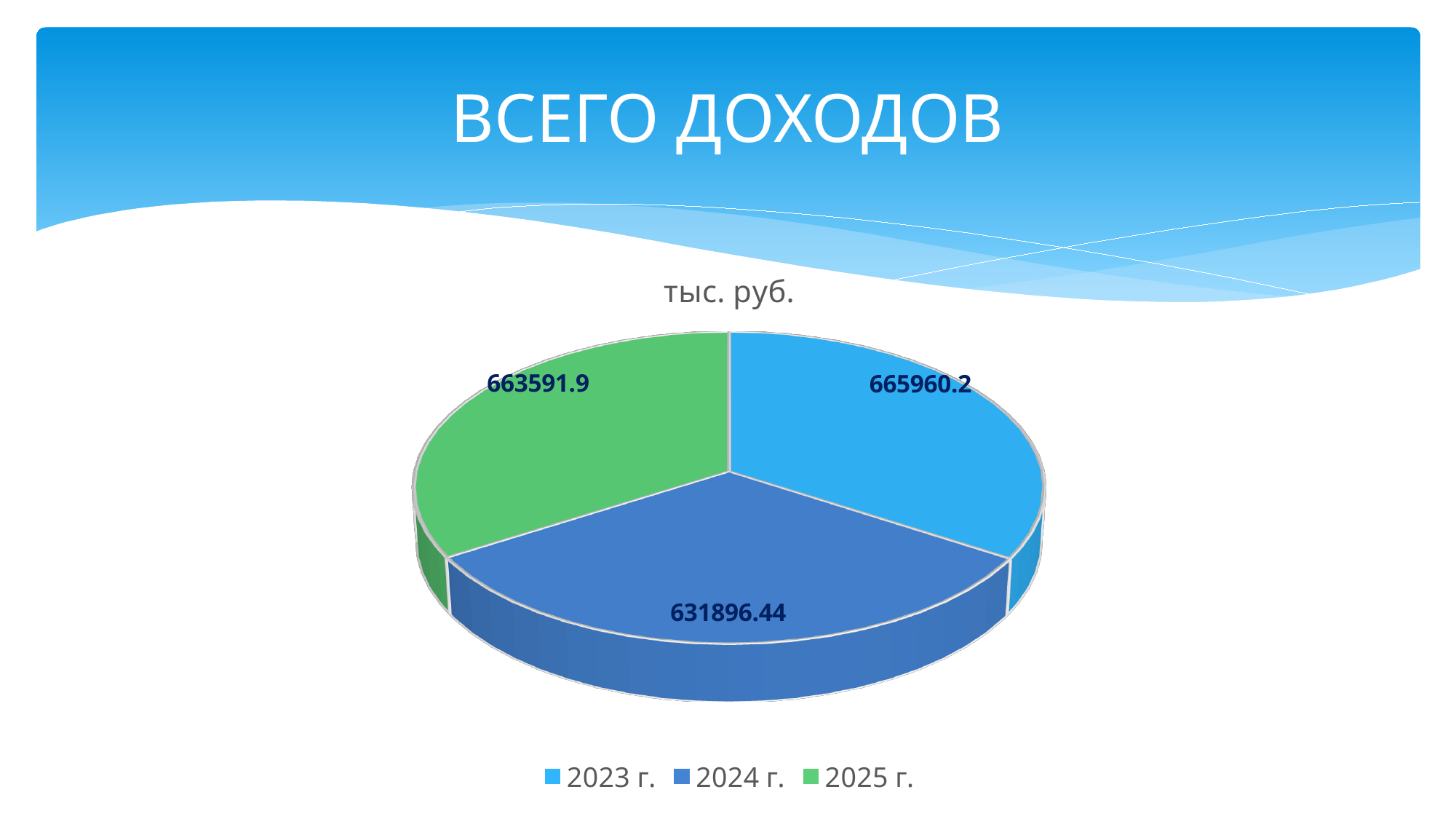
What is the value for 2024 г. in the pie chart? 631896.44 Which is larger, the value for 2025 г. or the value for 2024 г.? 2025 г. What is the difference between the values for 2025 г. and 2024 г.? 31695.46 What is the difference between the values for 2023 г. and 2024 г.? 34063.76 Which year has the smallest value in the pie chart? 2024 г. What is the title of the chart? тыс. руб. How many entries does the legend list? 3 Which year has the largest value in the pie chart? 2023 г. What is the value for 2023 г. in the pie chart? 665960.2 What kind of chart is shown on the slide? Pie chart How many slices does the pie chart have? 3 What is the value for 2025 г. in the pie chart? 663591.9